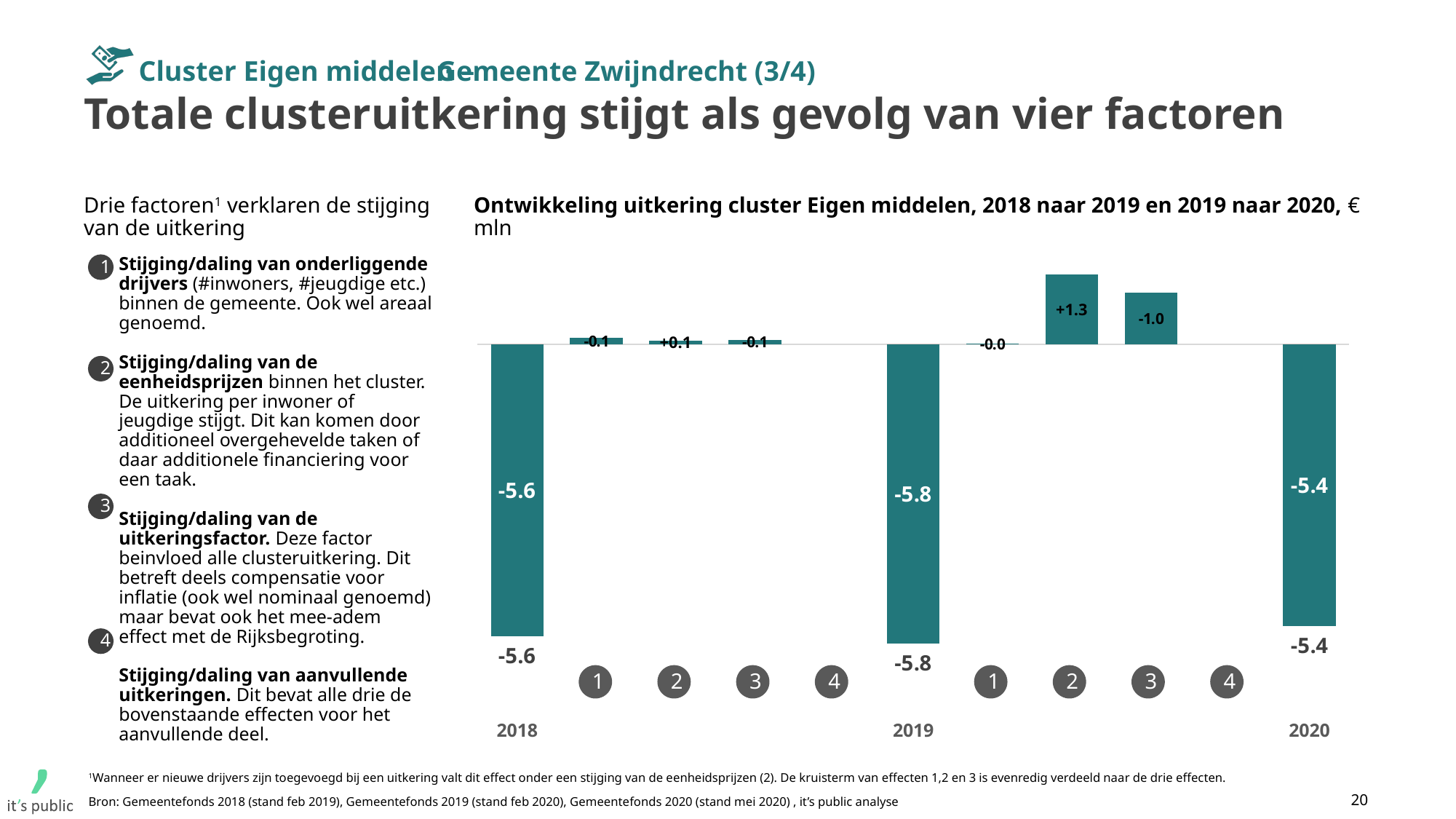
What is the value of the 2018 bar? -5.6 Which year has the highest total value: 2018, 2019 or 2020? 2020 What is the value of factor 1 in the change from 2019 to 2020? -0.0 What is the value of the 2019 bar? -5.8 What is the value of factor 3 in the change from 2019 to 2020? -1.0 What is the value of the 2020 bar? -5.4 What is the difference between the 2020 value and the 2019 value? 0.4 What is the value of factor 2 in the change from 2018 to 2019? +0.1 Which year has the lowest total value: 2018, 2019 or 2020? 2019 What is the unit stated in the chart title? € mln What type of chart is shown on the slide? bar chart What is the value of factor 2 in the change from 2019 to 2020? +1.3